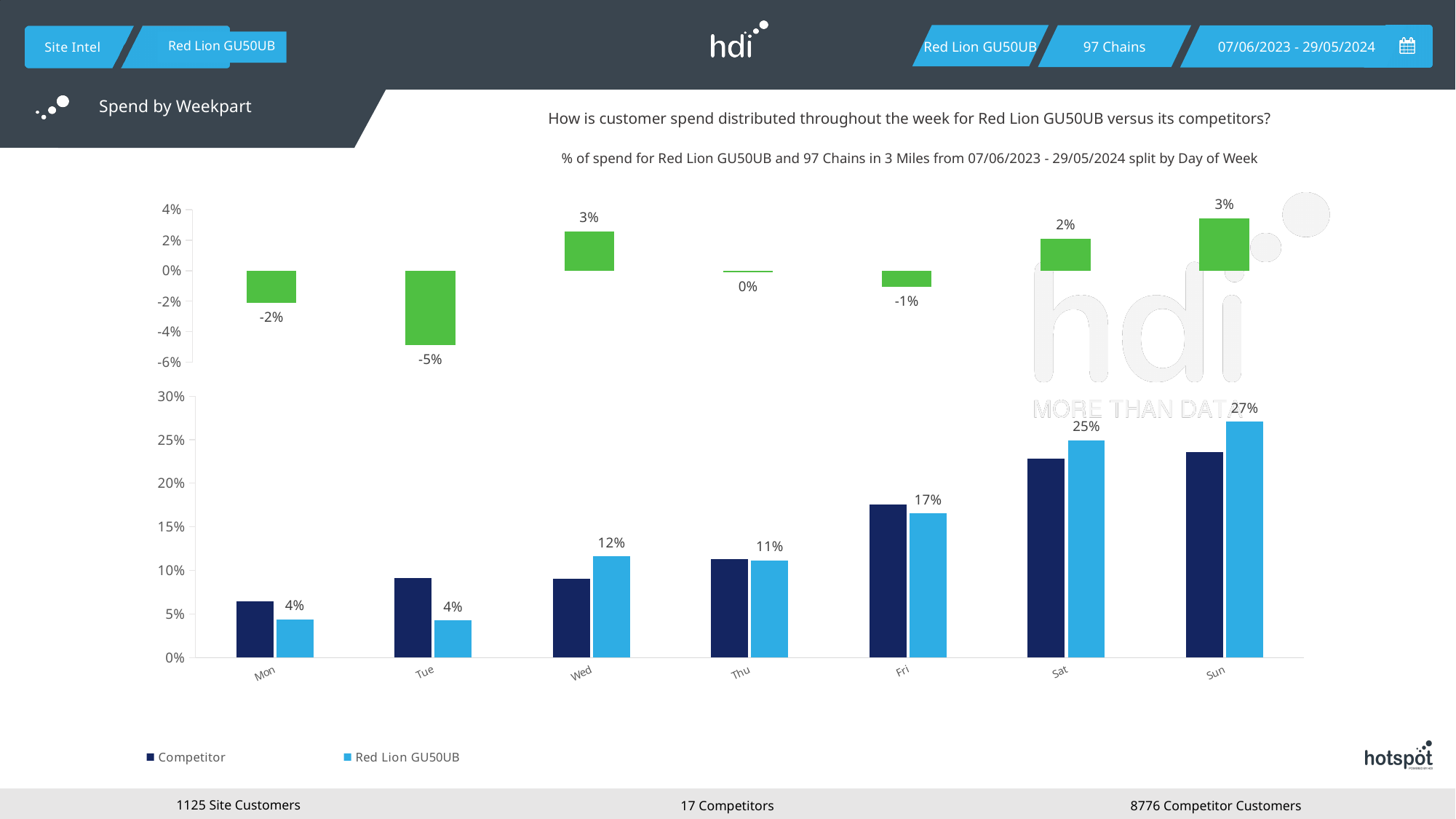
In the bottom chart, which day has the highest value for Red Lion GU50UB? Sun In the top chart, what is the value shown for Sat? 2% In the bottom chart, what is the difference between the Red Lion GU50UB values for Sat and Fri? 8% How many series does the legend of the bottom chart list? 2 In the top chart, which day has the lowest value? Tue In the bottom chart, what is the value for Red Lion GU50UB on Wed? 12% In the bottom chart, on Mon, which series has the larger value: Competitor or Red Lion GU50UB? Competitor In the bottom chart, is the Competitor value for Sat greater or less than 20%? greater In the top chart, what is the value shown for Tue? -5% In the bottom chart, what is the value for Red Lion GU50UB on Sun? 27% What type of chart is the bottom chart? Bar chart How many days of the week are shown on the x axis of the bottom chart? 7